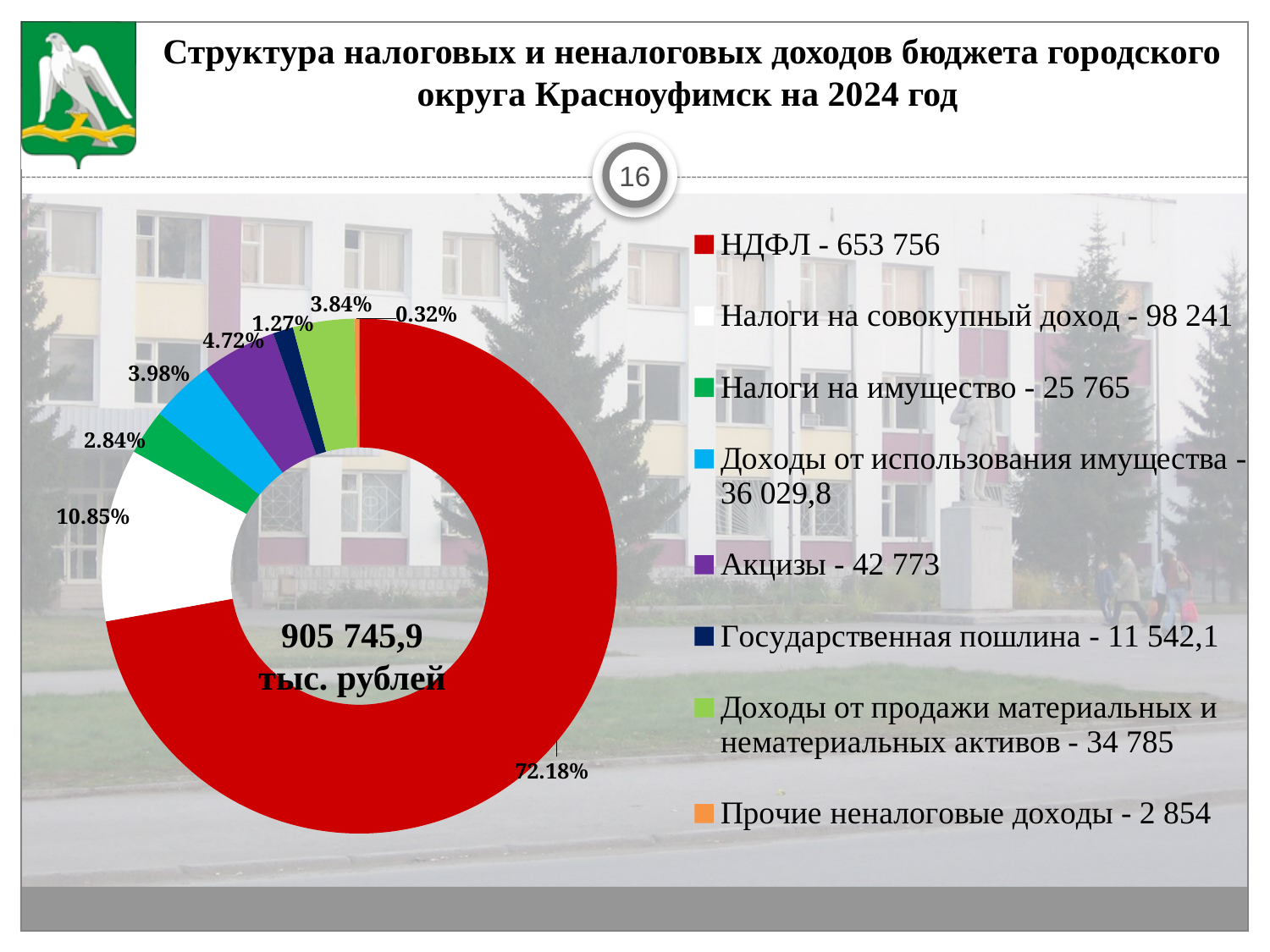
Which is larger: the share for Налоги на имущество or the share for Доходы от использования имущества? Доходы от использования имущества How many categories does the legend list? 8 What percentage share does Налоги на совокупный доход have? 10.85% What percentage share does Государственная пошлина have? 1.27% What value is given in the legend for Доходы от использования имущества? 36 029,8 What total is shown in the centre of the doughnut chart? 905 745,9 тыс. рублей Which category has the smallest share of the chart? Прочие неналоговые доходы What percentage share does НДФЛ have in the chart? 72.18% Which category has the largest share of the chart? НДФЛ What kind of chart is shown on the slide? Doughnut (pie) chart What value is given in the legend for Доходы от продажи материальных и нематериальных активов? 34 785